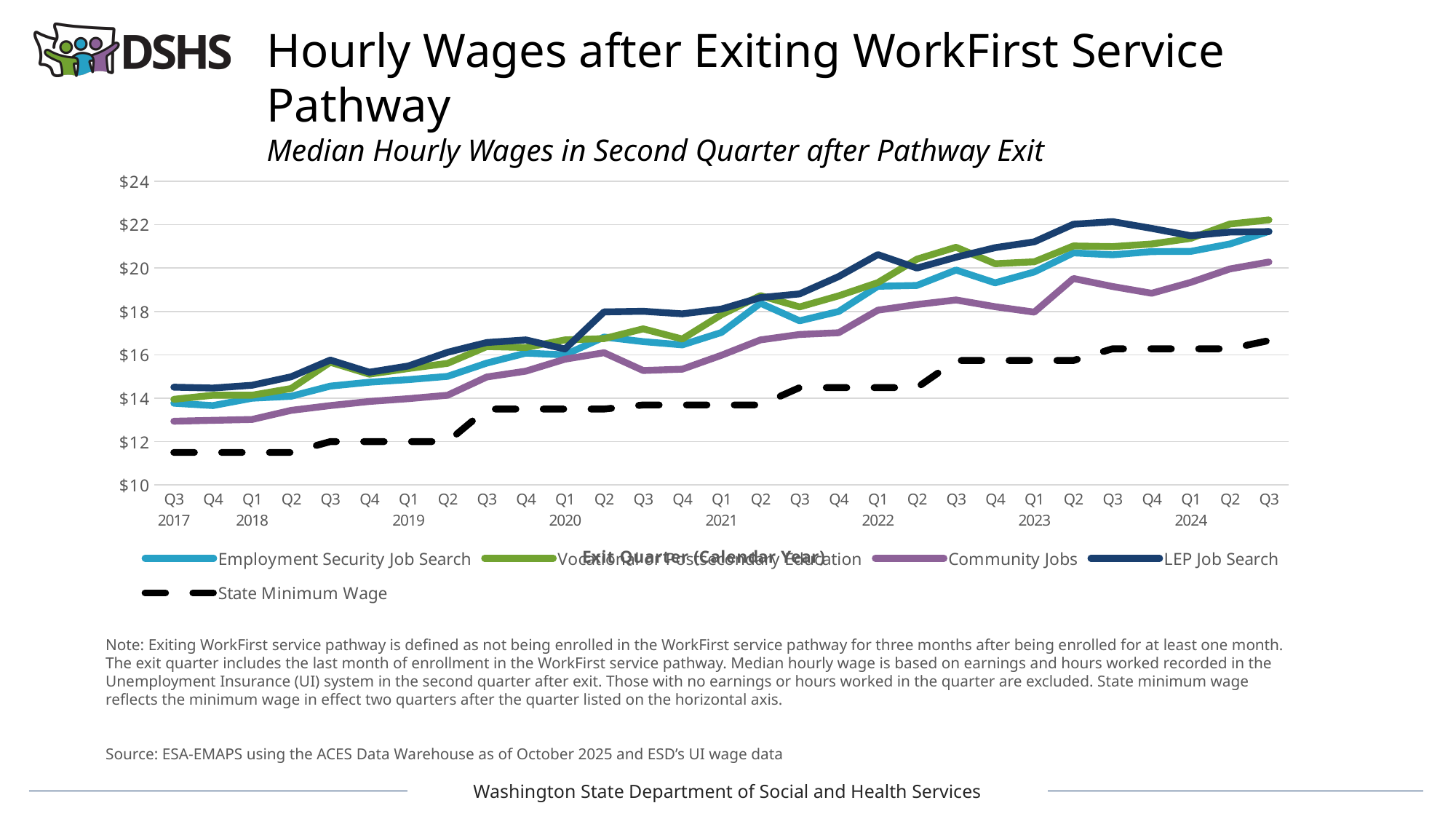
In Q3 2024, which is higher: Community Jobs or LEP Job Search? LEP Job Search Do the Community Jobs median hourly wages generally rise or fall from Q3 2017 to Q3 2024? rise Is the value for State Minimum Wage in Q3 2017 greater or less than $12? less Is the value for Community Jobs in Q3 2017 greater or less than $14? less What is the first exit quarter shown on the x axis? Q3 2017 How many series does the legend list? 5 Is the value for Community Jobs in Q3 2024 greater or less than $18? greater What is the subtitle of the chart? Median Hourly Wages in Second Quarter after Pathway Exit Which series has the lowest value in Q3 2024? State Minimum Wage How many exit quarters are plotted along the x axis? 29 What kind of chart is shown on the slide? Line chart